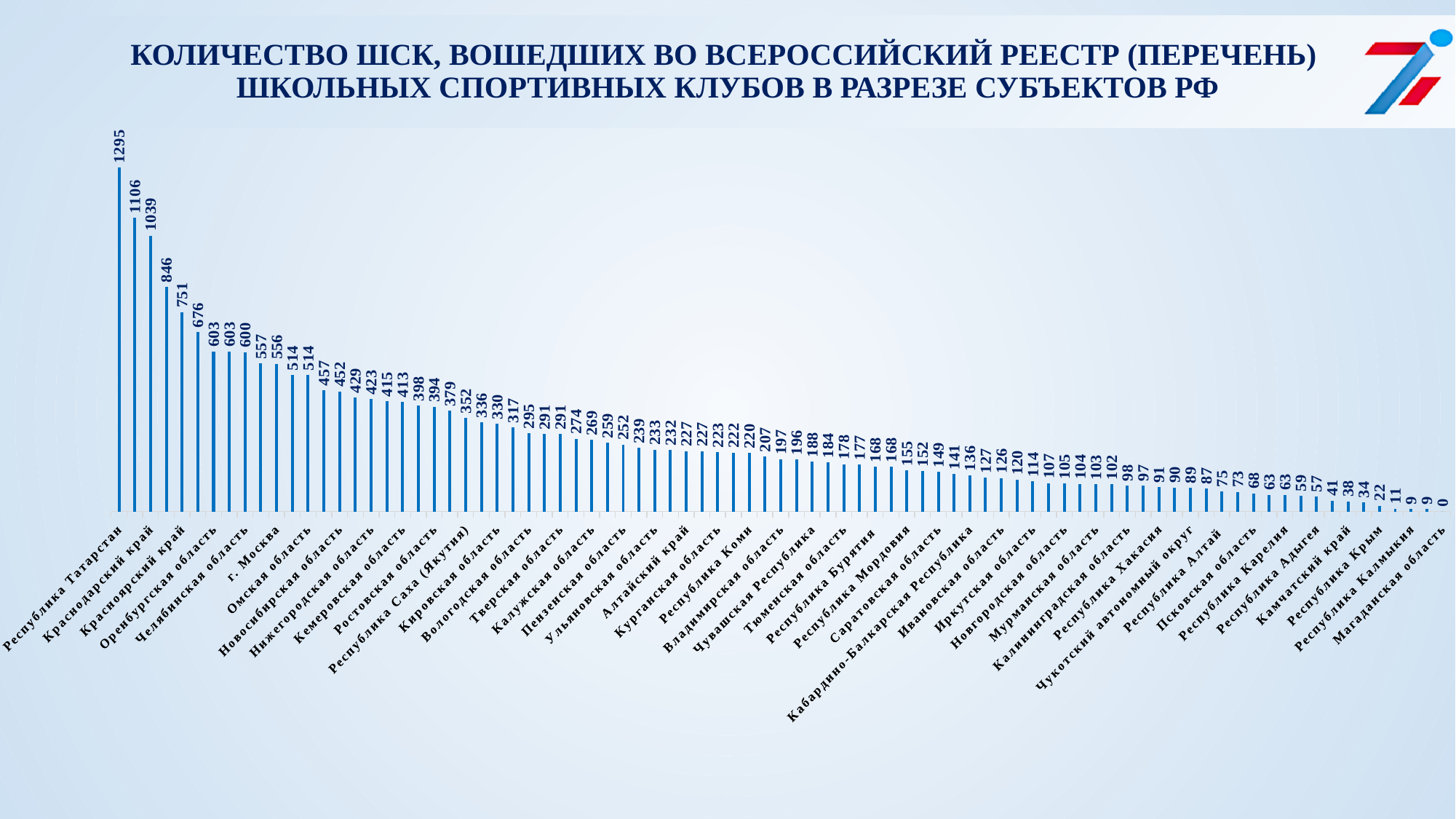
What colour are the bars in the chart? blue How many bars in the chart have a value above 1000? 3 What is the difference between the two highest values in the chart (1295 and 1106)? 189 What kind of chart is shown on the slide? bar chart Do the values rise or fall from left to right along the x axis? fall What is the value of the tallest bar in the chart? 1295 Which region has the highest number of school sports clubs in the chart? Республика Татарстан What is the value of the lowest bar in the chart? 0 How many bars in the chart have the value 603? 2 What is the value for Республика Татарстан? 1295 What is the title of the chart? КОЛИЧЕСТВО ШСК, ВОШЕДШИХ ВО ВСЕРОССИЙСКИЙ РЕЕСТР (ПЕРЕЧЕНЬ) ШКОЛЬНЫХ СПОРТИВНЫХ КЛУБОВ В РАЗРЕЗЕ СУБЪЕКТОВ РФ What is the difference between the highest value (1295) and the third-highest value (1039)? 256